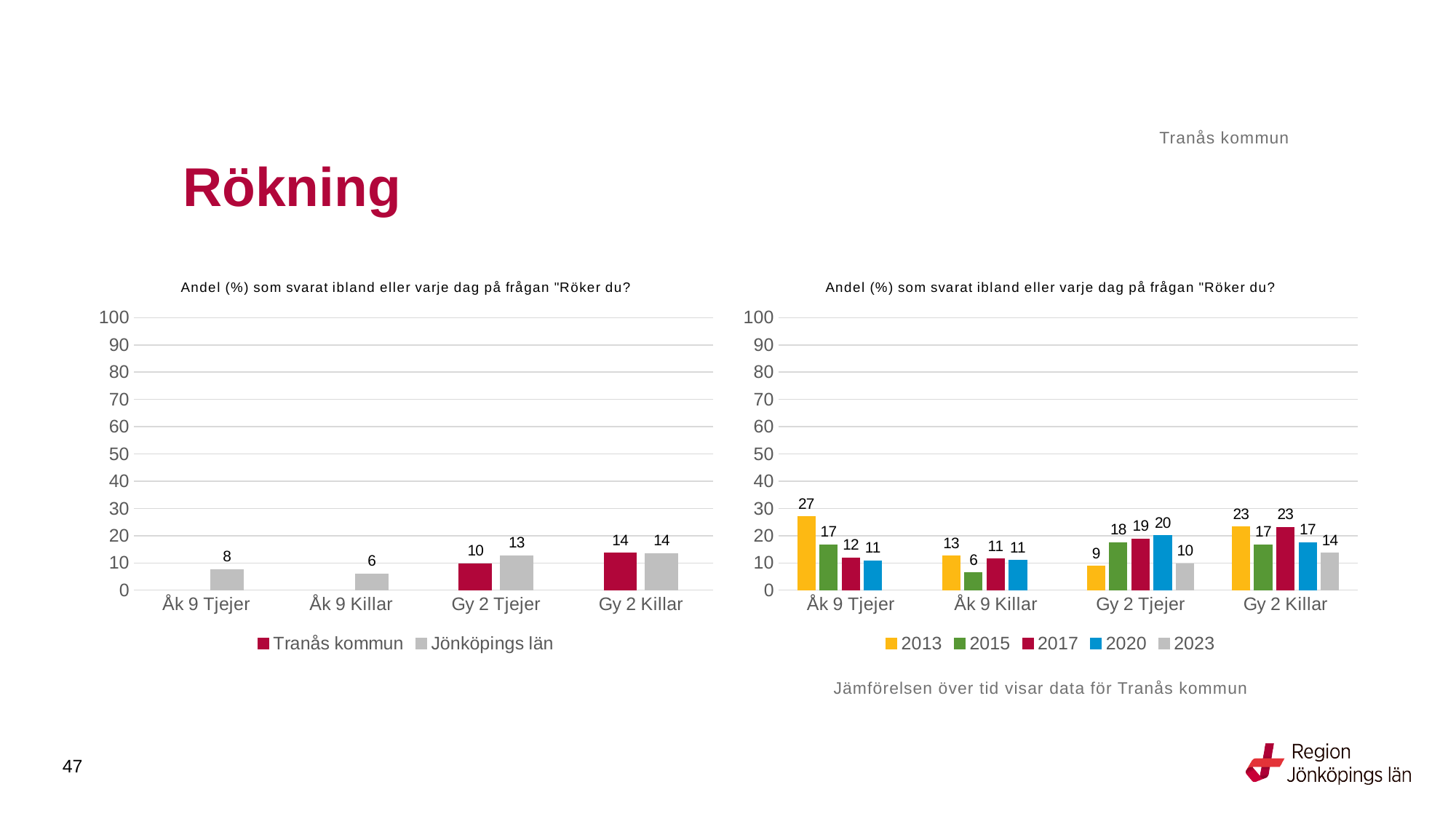
In the left chart, what is the difference between Jönköpings län and Tranås kommun for Gy 2 Tjejer? 3 What kind of chart is the right chart? Bar chart In the right chart, which year has the highest value for Gy 2 Tjejer? 2020 In the left chart, how many series does the legend list? 2 In the left chart, which category has the lowest value for Jönköpings län? Åk 9 Killar In the right chart, how many series does the legend list? 5 In the right chart, which is larger for Åk 9 Killar: 2013 or 2015? 2013 In the left chart, what is the value for Jönköpings län for Gy 2 Tjejer? 13 In the right chart, what is the value for 2013 for Åk 9 Tjejer? 27 In the left chart, what is the value for Tranås kommun for Gy 2 Killar? 14 In the right chart, what is the value for 2023 for Gy 2 Killar? 14